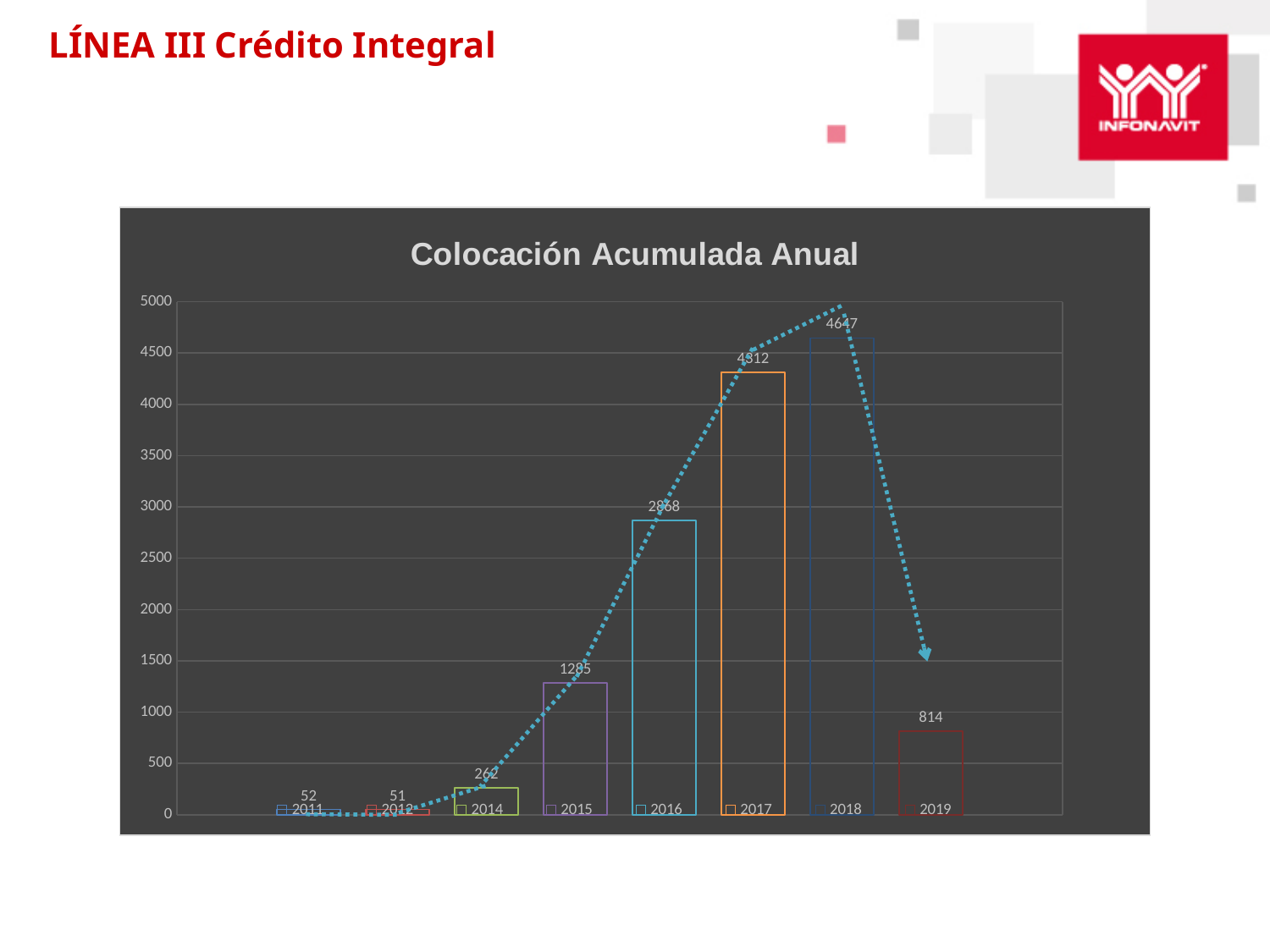
What kind of chart is shown on the slide? bar chart How many years are shown on the x axis of the chart? 8 What is the title of the chart? Colocación Acumulada Anual What is the value for 2018? 4647 Is the value for 2017 greater or less than 4000? greater What is the value for 2011? 52 What is the difference between the values for 2018 and 2019? 3833 Which year has the highest value? 2018 Which is larger, the value for 2017 or the value for 2019? 2017 What is the value for 2012? 51 What is the value for 2019? 814 Is the value for 2019 greater or less than 1000? less